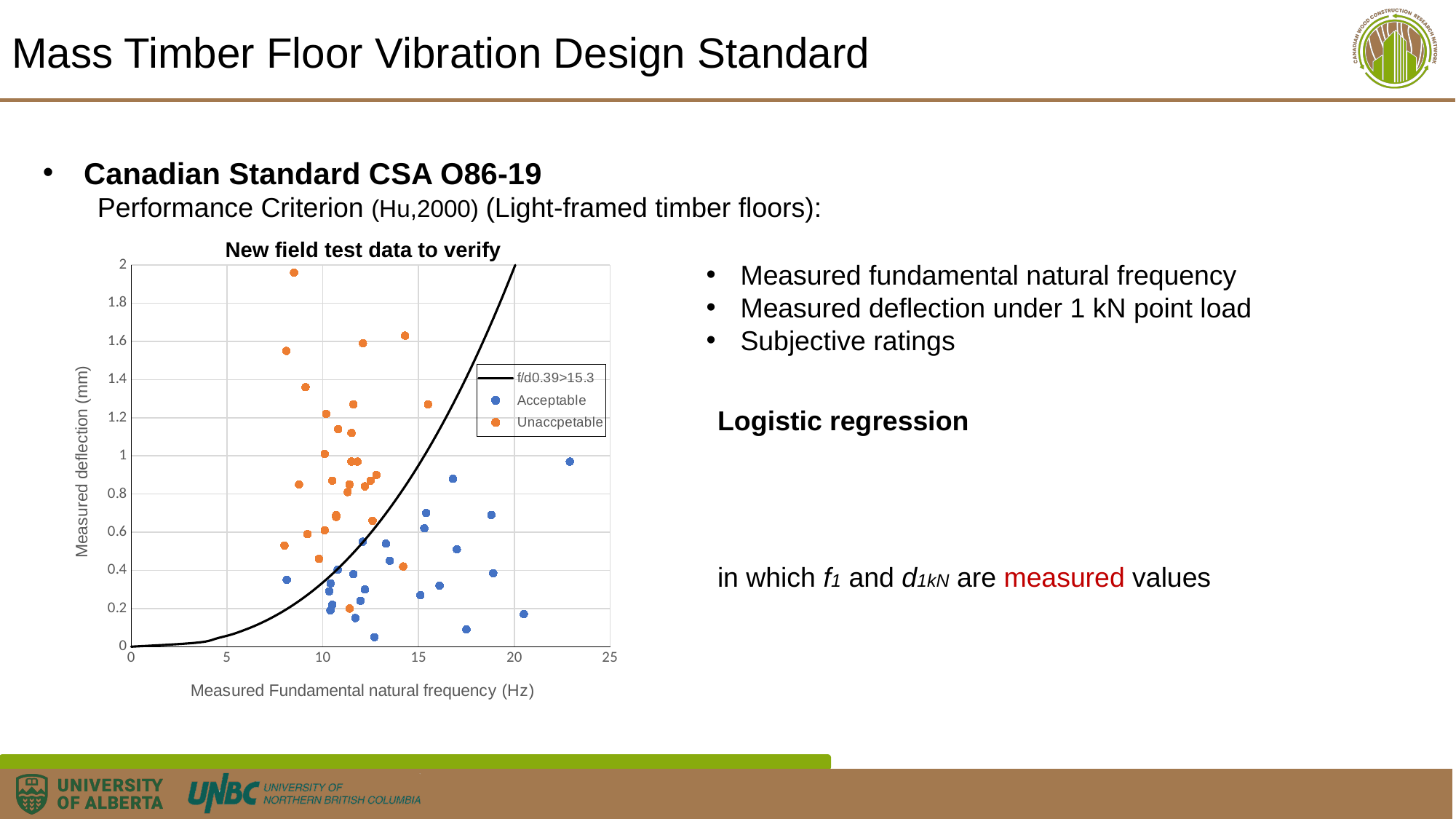
Is the measured deflection of the lowest Acceptable point greater or less than 0.2 mm? less Does the black f/d0.39>15.3 line rise or fall as frequency increases along the x axis? rise Which legend entry is drawn as a black line in the chart? f/d0.39>15.3 What is the highest value shown on the horizontal axis of the chart? 25 What is the highest value shown on the vertical axis of the chart? 2 What is the label of the horizontal axis of the chart? Measured Fundamental natural frequency (Hz) How many entries does the legend of the chart list? 3 What kind of chart is shown on the slide? Scatter chart What is the label of the vertical axis of the chart? Measured deflection (mm) Is the measured deflection of the highest Unaccpetable point greater or less than 1.8 mm? greater What is the title of the chart? New field test data to verify Is the measured deflection of the Acceptable point with the highest frequency (near 23 Hz) greater or less than 0.8 mm? greater